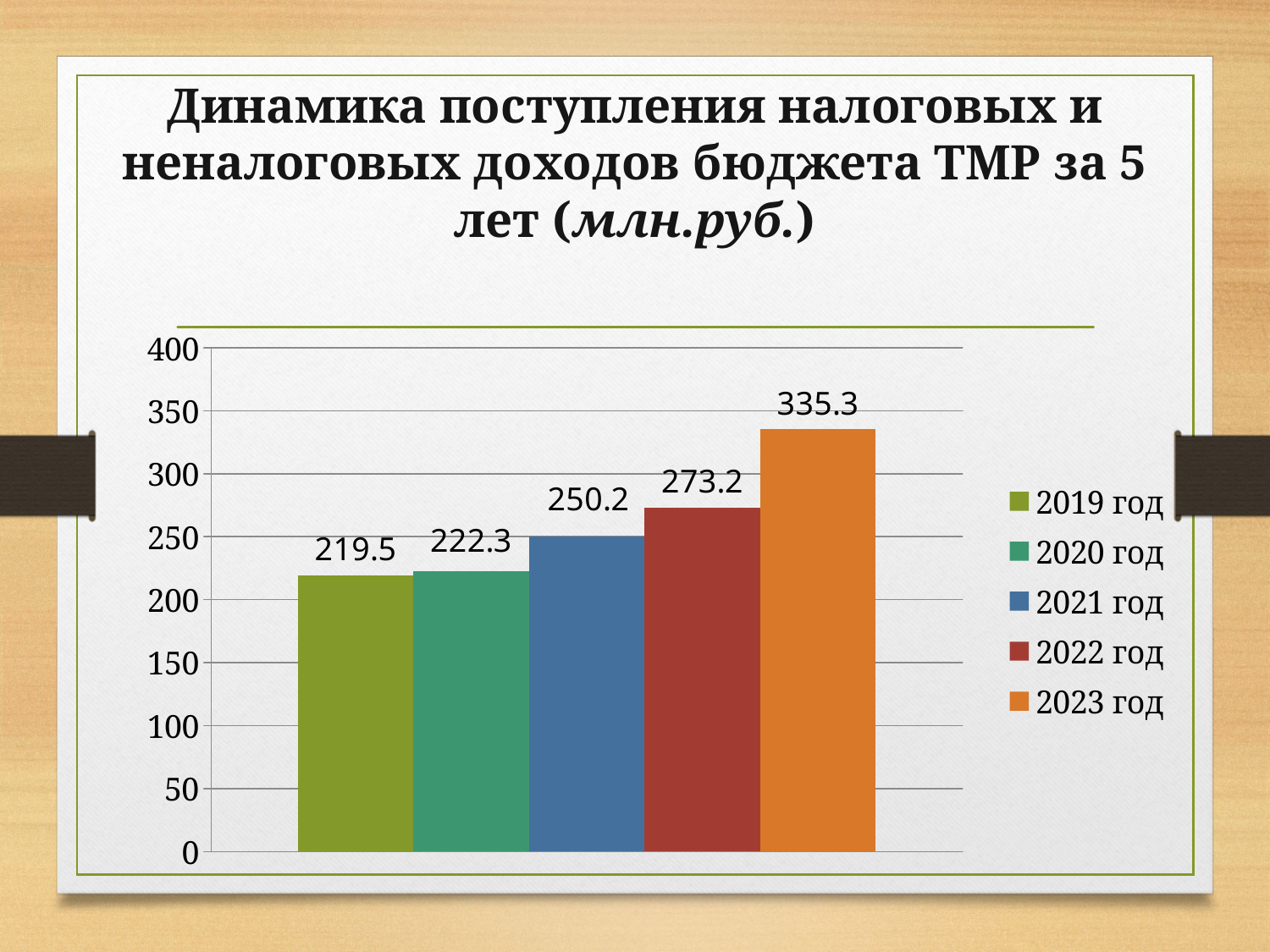
Is the value for 2023 год greater or less than 300? greater Which is larger, the value for 2021 год or the value for 2020 год? 2021 год What is the difference between the values for 2021 год and 2020 год? 27.9 What is the value for 2019 год? 219.5 Do the values rise or fall from 2019 год to 2023 год? rise What is the value for 2021 год? 250.2 What is the difference between the values for 2023 год and 2022 год? 62.1 Which year has the lowest value? 2019 год What kind of chart is shown on the slide? bar chart Which year has the highest value? 2023 год How many series does the legend list? 5 What is the value for 2022 год? 273.2